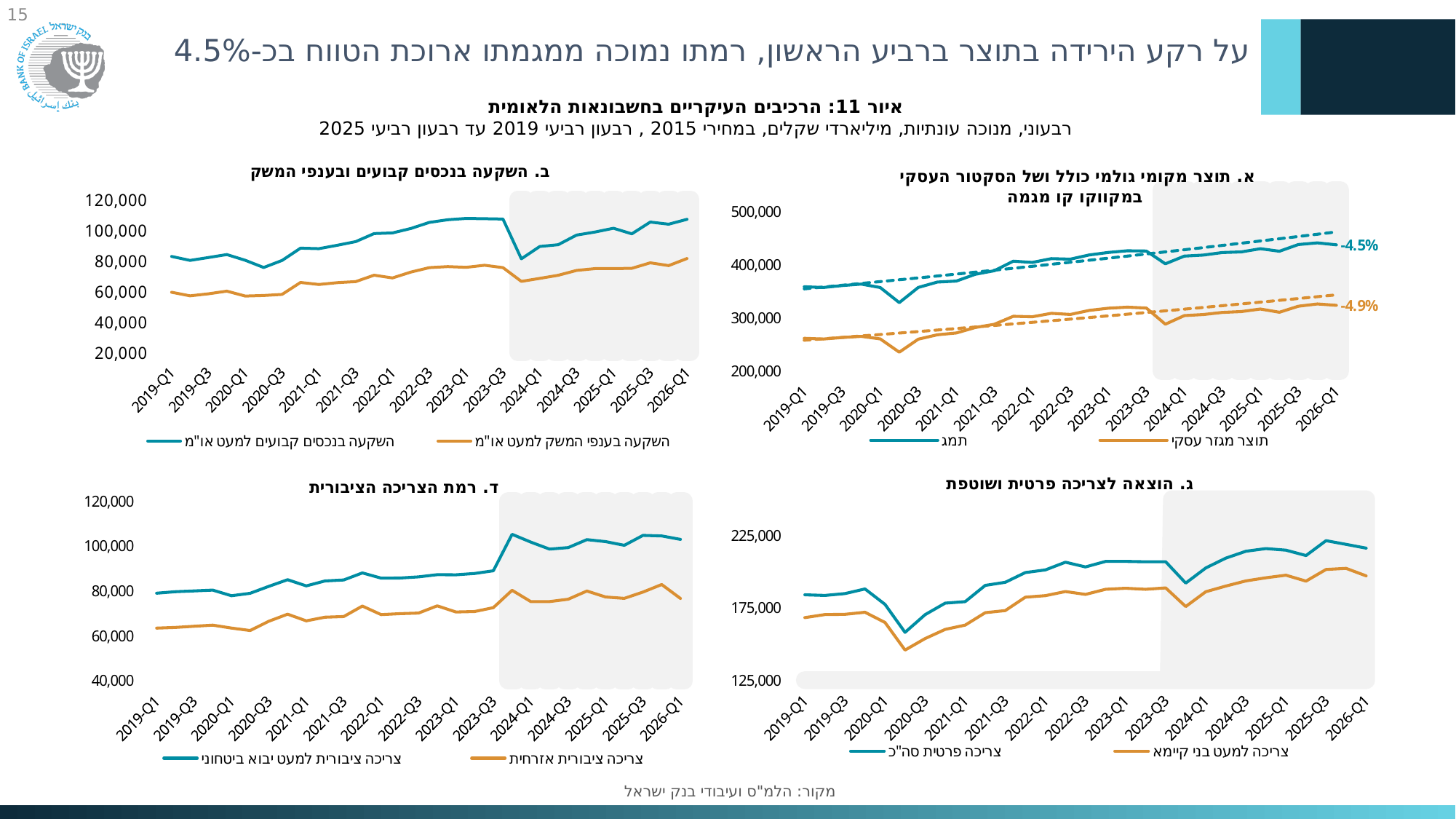
In chart ב (top left), which series is higher at 2023-Q1: השקעה בנכסים קבועים למעט או"מ or השקעה בענפי המשק למעט או"מ? השקעה בנכסים קבועים למעט או"מ How many series does the legend of chart ב (top left, investment) list? 2 What is the title of the bottom-left chart (ד)? ד. רמת הצריכה הציבורית In chart ג (bottom right, consumption expenditure), is the value of צריכה למעט בני קיימא at 2020-Q3 greater or less than 175,000? less In chart א (top right), what growth rate is labeled on the dashed trend line for תמ"ג? 4.5% In chart א (top right), is the value of תוצר מגזר עסקי at 2020-Q3 greater or less than 300,000? less In chart ג (bottom right), does צריכה פרטית סה"כ overall rise or fall from 2019-Q1 to 2026-Q1? rise In chart א (top right), what growth rate is labeled on the dashed trend line for תוצר מגזר עסקי? 4.9% In chart א (top right), is the value of תמ"ג at 2020-Q3 greater or less than 400,000? less What kind of chart is chart א (top right, GDP and business sector product)? line chart